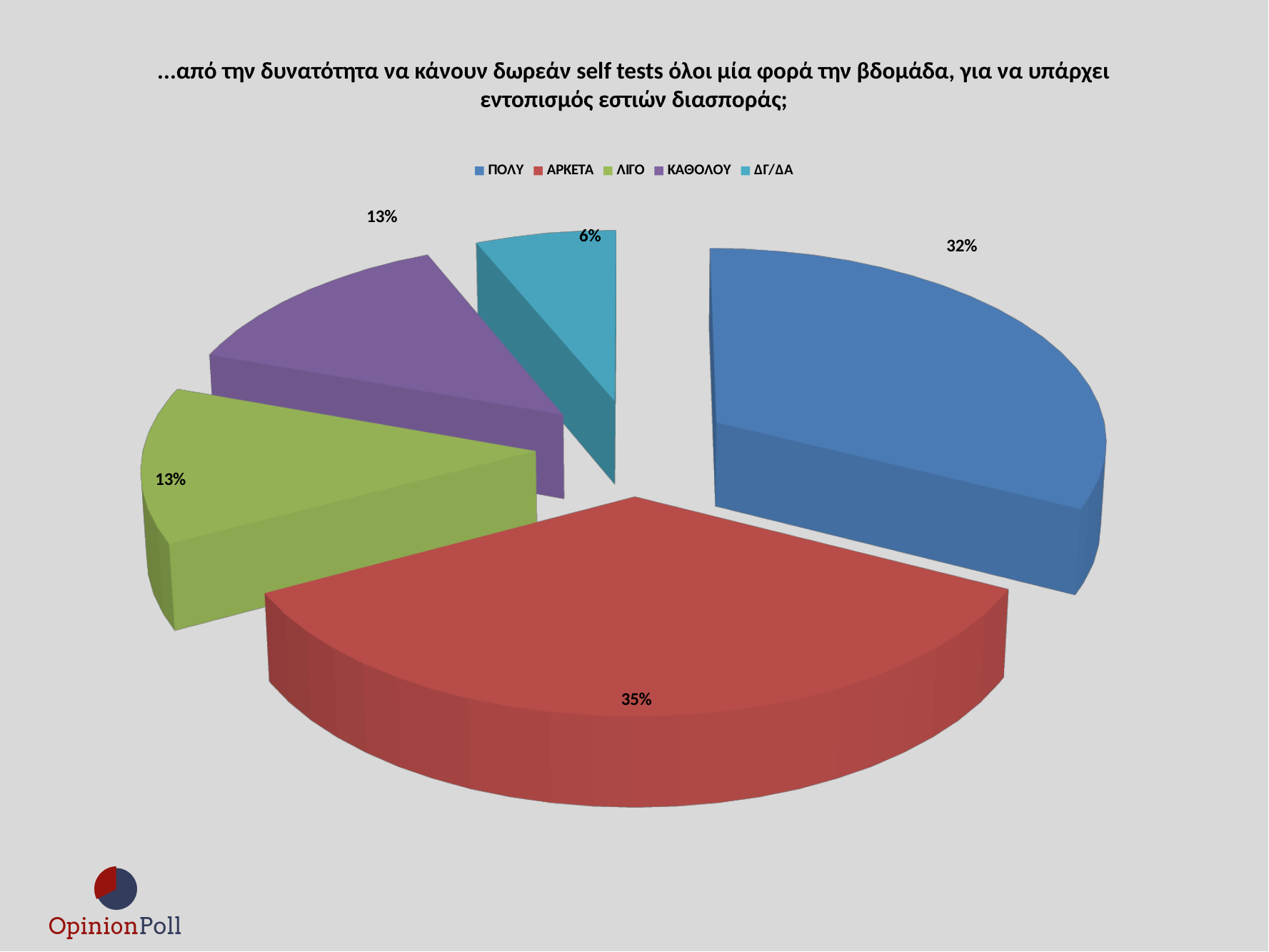
What percentage is shown for ΔΓ/ΔΑ? 6% What is the combined share of ΠΟΛΥ and ΑΡΚΕΤΑ? 67% Which colour represents ΚΑΘΟΛΟΥ in the chart? Purple How many categories does the legend list? 5 Which category has the smallest share of the pie? ΔΓ/ΔΑ What is the difference in percentage points between ΑΡΚΕΤΑ and ΠΟΛΥ? 3 What percentage is shown for ΠΟΛΥ? 32% What percentage is shown for ΛΙΓΟ? 13% What percentage is shown for ΑΡΚΕΤΑ? 35% Which is larger, the share for ΠΟΛΥ or the share for ΚΑΘΟΛΟΥ? ΠΟΛΥ Which category has the largest share of the pie? ΑΡΚΕΤΑ What kind of chart is shown on the slide? Pie chart